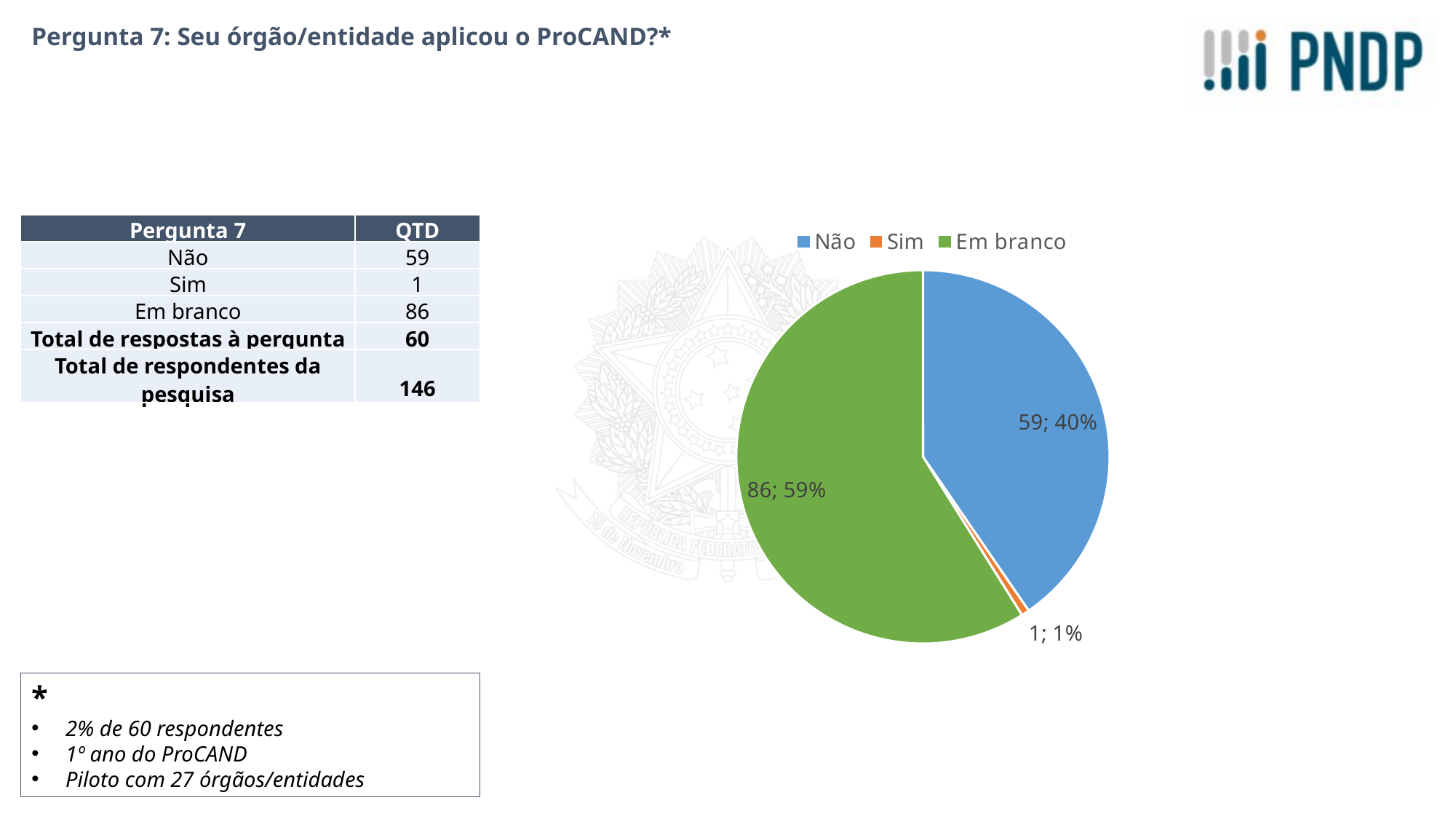
What is the count shown for the 'Não' slice of the pie chart? 59 What is the count shown for the 'Em branco' slice of the pie chart? 86 Which colour represents 'Sim' in the pie chart? orange Which slice of the pie chart is the smallest? Sim What is the difference between the counts for 'Em branco' and 'Não' in the pie chart? 27 Which slice of the pie chart is the largest? Em branco What kind of chart is shown on the slide? pie chart What percentage share does the 'Não' slice represent in the pie chart? 40% What is the count shown for the 'Sim' slice of the pie chart? 1 What percentage share does the 'Em branco' slice represent in the pie chart? 59% How many entries does the pie chart legend list? 3 How many slices does the pie chart have? 3